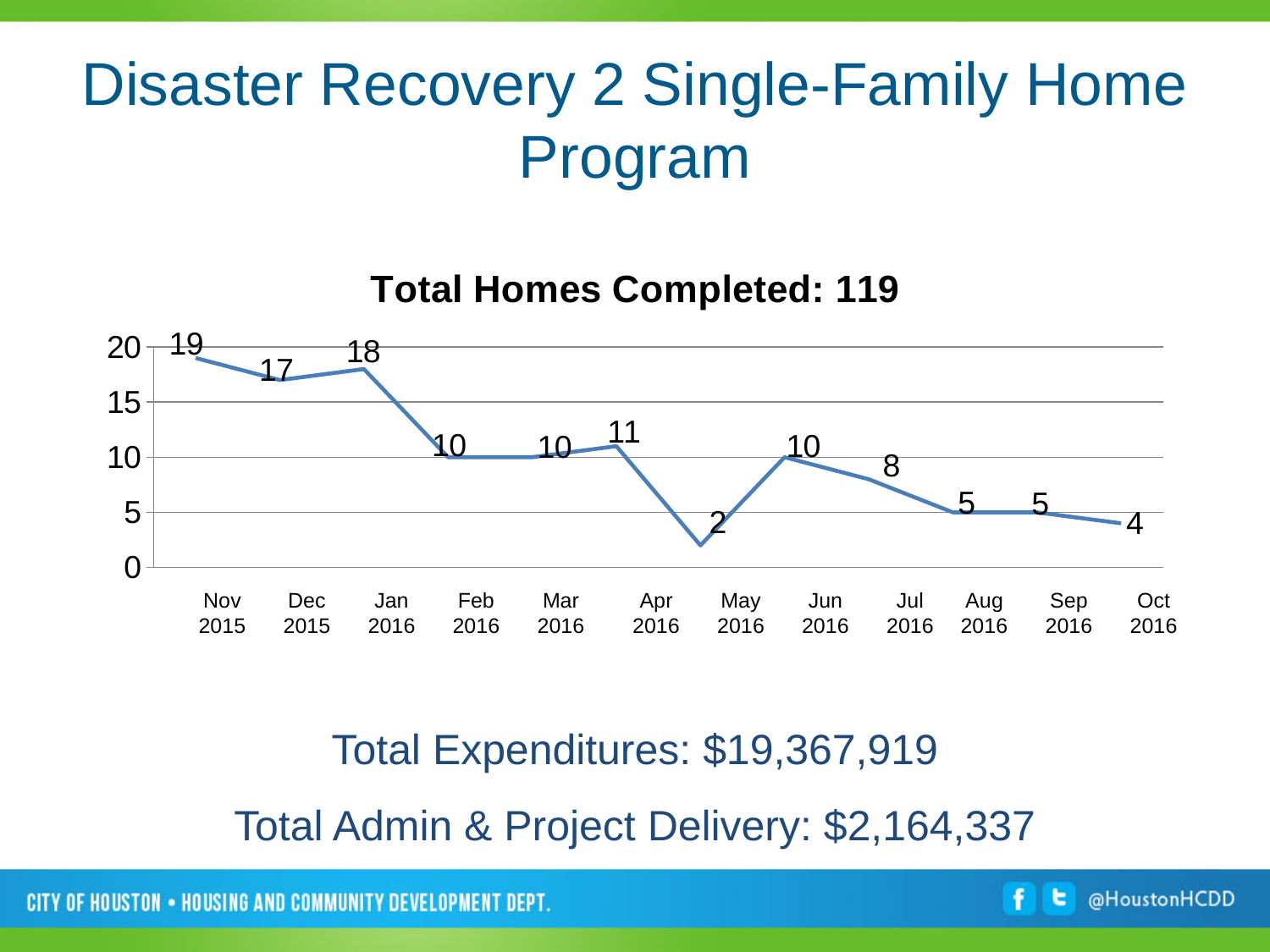
How many homes were completed in Nov 2015? 19 What is the value for Oct 2016? 4 Which is larger, the value for Jun 2016 or the value for Jul 2016? Jun 2016 How many months are plotted on the x axis? 12 Which month has the highest number of homes completed? Nov 2015 What is the chart's title? Total Homes Completed: 119 What is the difference between the values for Jan 2016 and Feb 2016? 8 Is the value for Dec 2015 greater or less than 15? greater What is the value for May 2016? 2 What type of chart is shown on the slide? line chart Which month has the lowest number of homes completed? May 2016 Do the values generally rise or fall from Nov 2015 to Oct 2016? fall